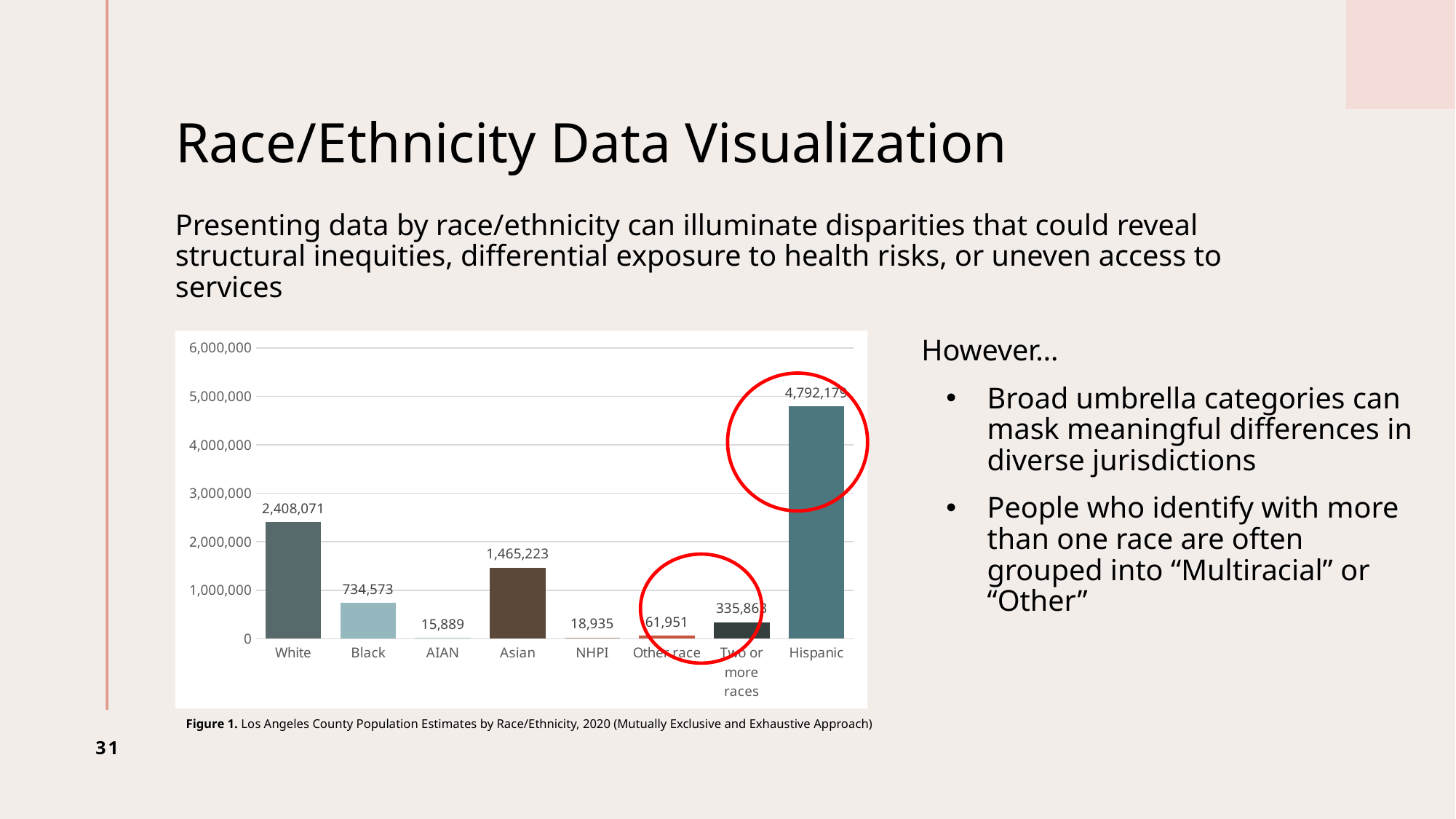
Which race/ethnicity category has the highest population estimate? Hispanic Which has a larger population estimate, Black or Asian? Asian What is the population estimate for Asian in the chart? 1,465,223 How many race/ethnicity categories are shown in the chart? 8 What is the population estimate for AIAN in the chart? 15,889 Is the value for Hispanic greater or less than 4,000,000? greater What kind of chart is shown on the slide? bar chart What is the population estimate for Other race in the chart? 61,951 Which race/ethnicity category has the lowest population estimate? AIAN What is the difference between the White and Asian population estimates? 942,848 What is the population estimate for Black in the chart? 734,573 What is the population estimate for White in the chart? 2,408,071